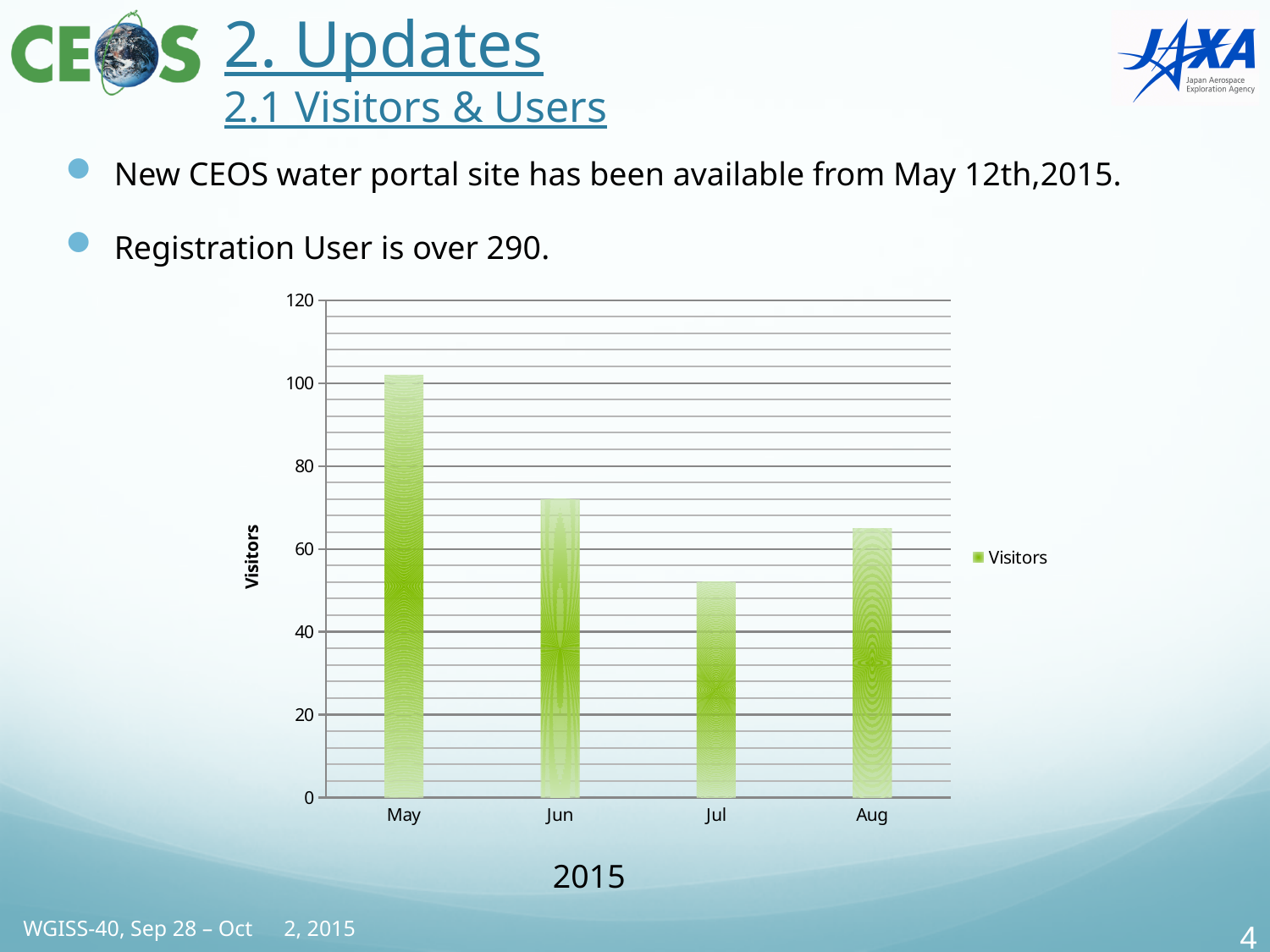
What year is shown below the chart's x axis? 2015 Is the value for May greater or less than 100? greater Is the value for Jun greater or less than 80? less How many months are shown on the x axis of the chart? 4 Which month has the highest number of visitors? May How many series does the chart legend list? 1 Is the value for Aug greater or less than 60? greater What kind of chart is shown on the slide? bar chart What is the label of the vertical axis of the chart? Visitors Which month has the lowest number of visitors? Jul Which month has more visitors, Jun or Aug? Jun